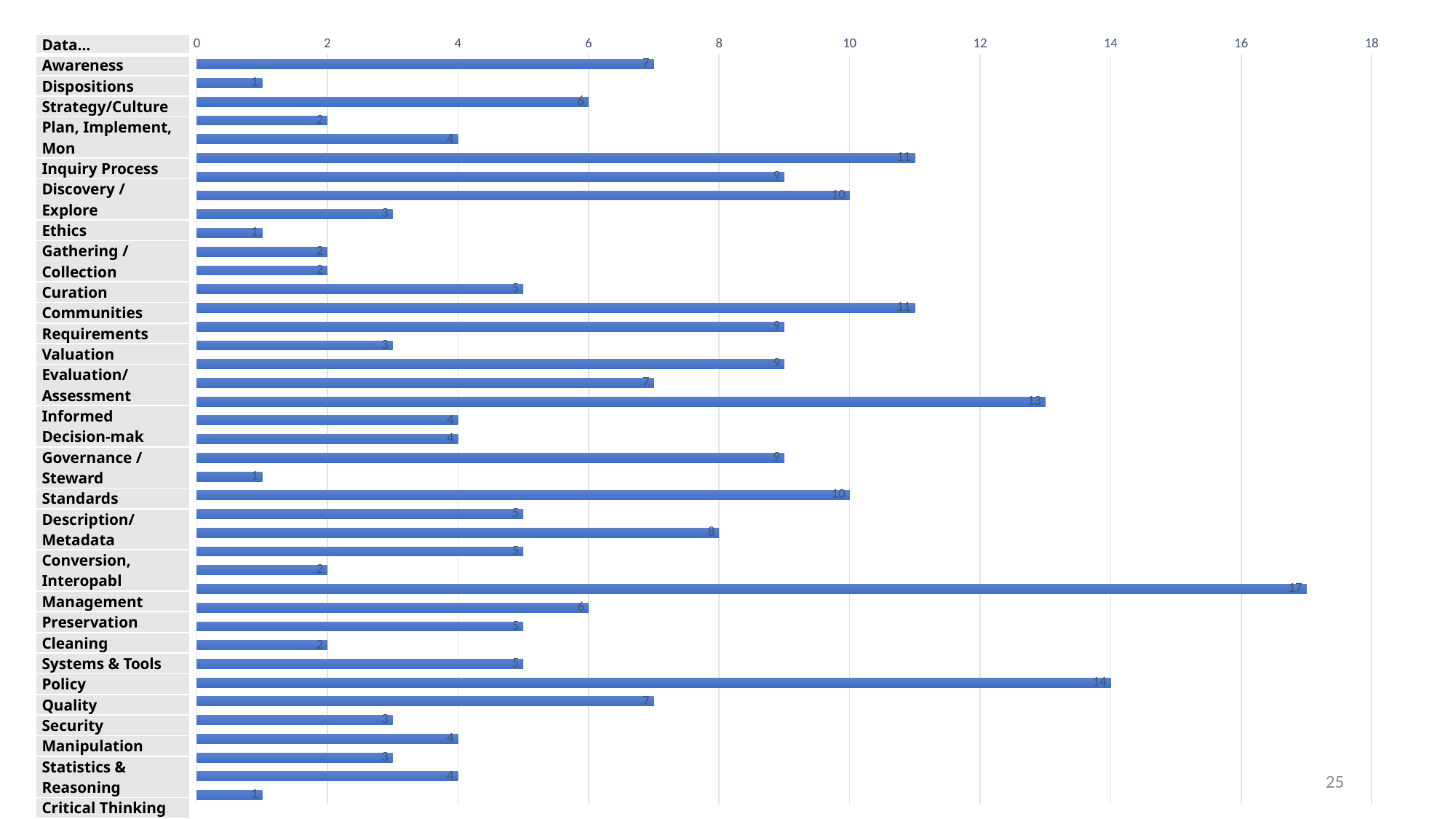
What is the second-highest value shown on the chart? 14 What type of chart is shown on the slide? bar chart What is the value of the bottom bar on the chart? 1 What is the maximum value shown on the horizontal axis? 18 How many bars are plotted on the chart? 40 What is the highest value shown by any bar on the chart? 17 What is the difference between the highest bar value (17) and the second-highest bar value (14)? 3 What colour are the bars on the chart? blue What is the value of the topmost bar on the chart? 7 Is the longest bar on the chart greater or less than 16? greater What is the lowest value shown by any bar on the chart? 1 How many bars on the chart have a value of 1? 4